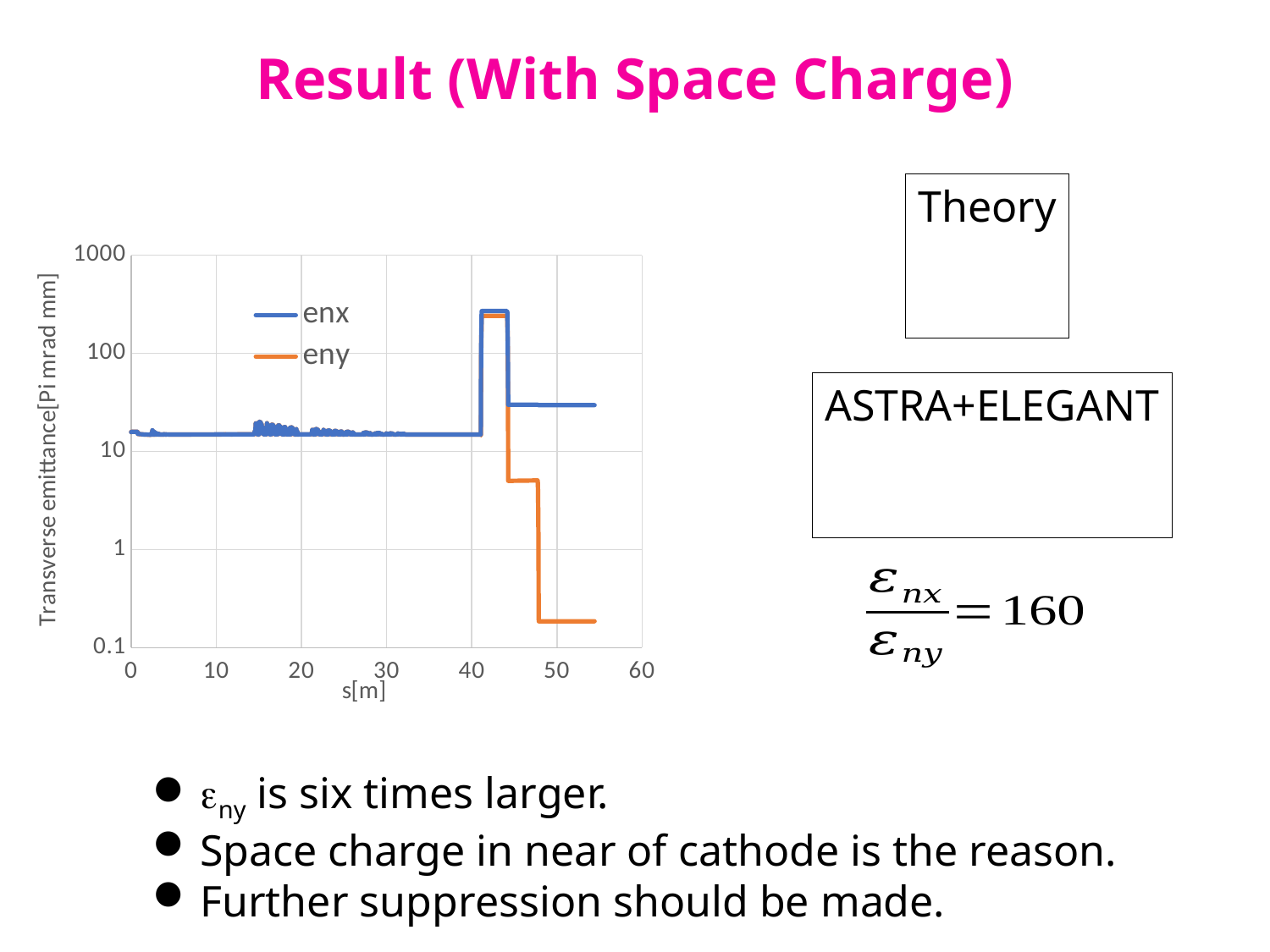
Is the value of enx at s = 20 m greater or less than 100? less Does the eny series rise or fall between s = 44 m and s = 50 m? fall Is the value of eny at s = 30 m greater or less than 10? greater Is the value of eny at s = 50 m greater or less than 1? less At s = 50 m, which series has the larger value, enx or eny? enx How many series does the chart legend list? 2 What is the highest tick value shown on the chart's y axis? 1000 What are the two series named in the chart legend? enx and eny What kind of chart is shown on the slide? line chart What is the label of the chart's y axis? Transverse emittance[Pi mrad mm]